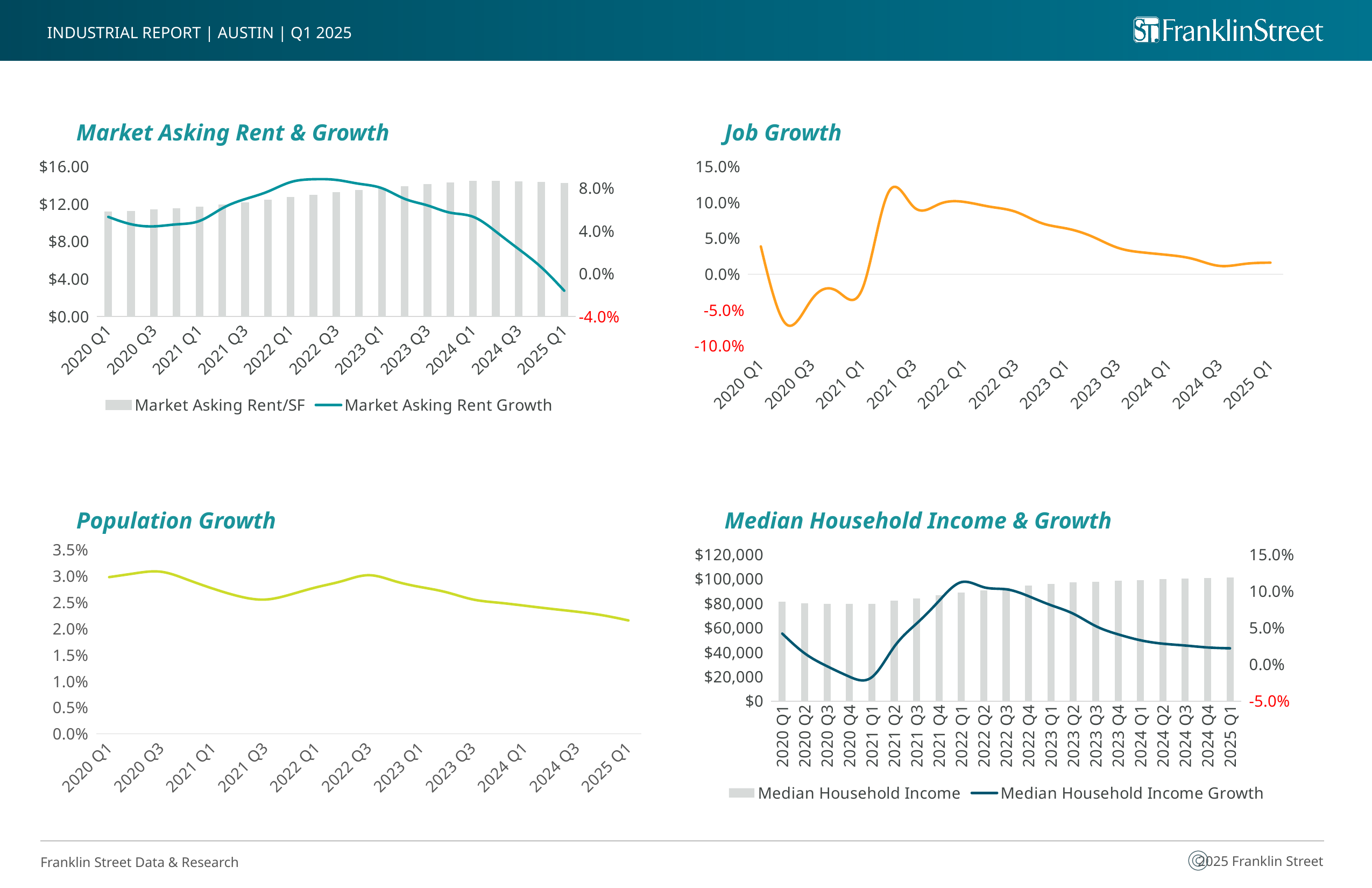
In the Job Growth chart, which quarter has the lowest job growth? 2020 Q2 In the Population Growth chart, is the value for 2025 Q1 greater or less than 2.5%? less In the Market Asking Rent & Growth chart, is the Market Asking Rent Growth value for 2025 Q1 greater or less than 0.0%? less In the Market Asking Rent & Growth chart, how many series does the legend list? 2 In the Job Growth chart, does job growth rise or fall from 2021 Q3 to 2025 Q1? fall What kind of chart is the Population Growth chart? line chart In the Job Growth chart, is the value for 2021 Q3 greater or less than 10.0%? less In the Market Asking Rent & Growth chart, how many bars are plotted for Market Asking Rent/SF? 21 In the Median Household Income & Growth chart, which quarter has the highest Median Household Income Growth? 2022 Q1 How many charts are shown on the slide? 4